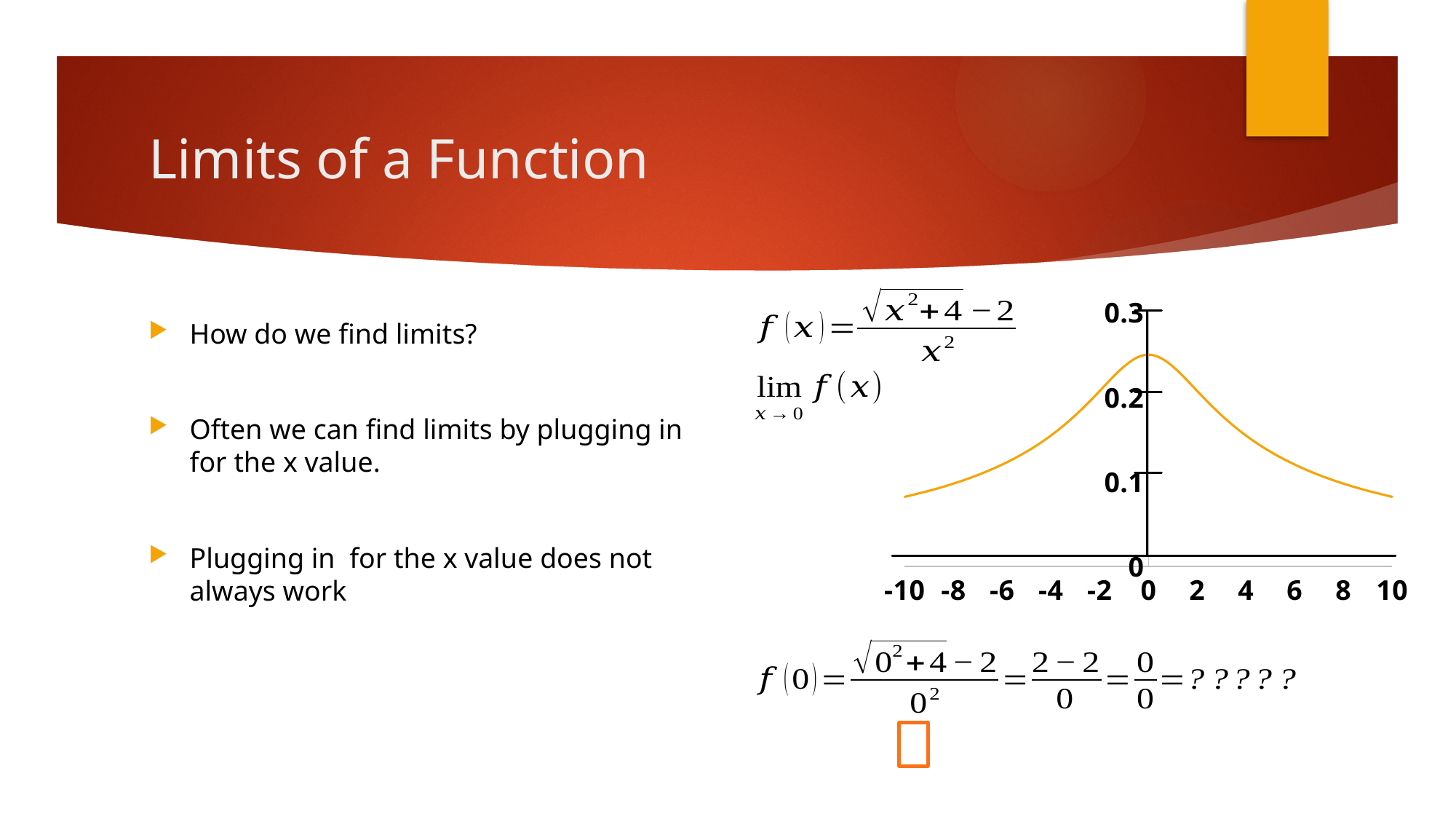
Is the value of the curve at x = -10 greater or less than 0.1? less Which has the larger value on the curve, x = 2 or x = 8? x = 2 What is the highest tick label shown on the y axis? 0.3 Is the value of the curve at x = 0 greater or less than 0.2? greater Which has the larger value on the curve, x = -4 or x = 0? x = 0 Do the values of the curve rise or fall as x goes from -10 to 0? rise How many tick labels are shown on the x axis? 11 Do the values of the curve rise or fall as x goes from 0 to 10? fall At which x value does the plotted curve reach its highest point? 0 Is the value of the curve at x = 10 greater or less than 0.1? less What kind of chart is shown on the slide? line chart